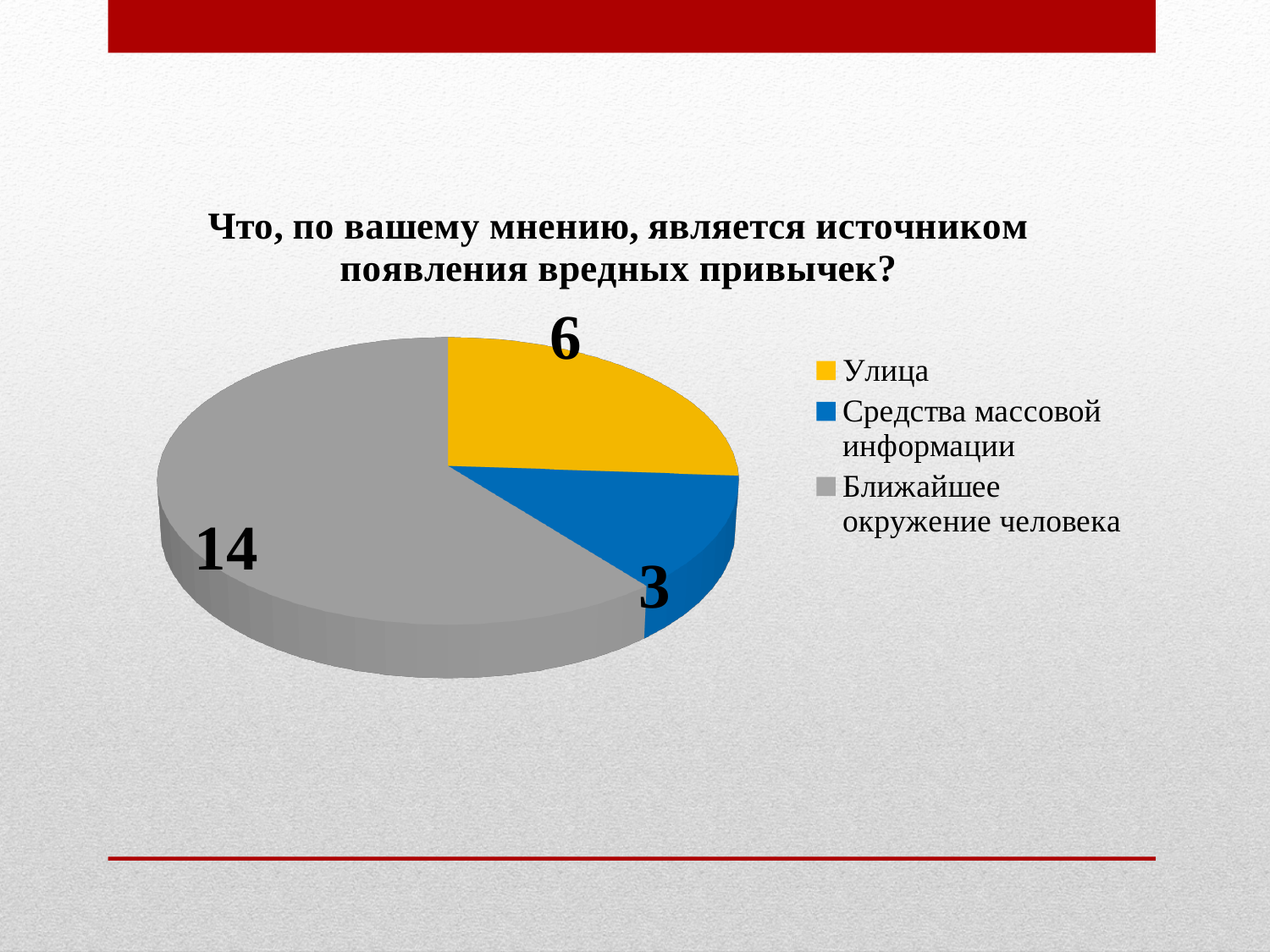
What is the difference between the values for Улица and Средства массовой информации? 3 What colour is the slice for Ближайшее окружение человека? Gray What is the value for Ближайшее окружение человека? 14 Which category has the largest slice of the pie? Ближайшее окружение человека What type of chart is shown on the slide? Pie chart Which category has the smallest slice of the pie? Средства массовой информации What is the value for Улица? 6 How many categories does the pie chart have? 3 What is the difference between the values for Ближайшее окружение человека and Улица? 8 Which is larger, the value for Улица or the value for Средства массовой информации? Улица What is the value for Средства массовой информации? 3 What is the total of all the slices in the pie chart? 23